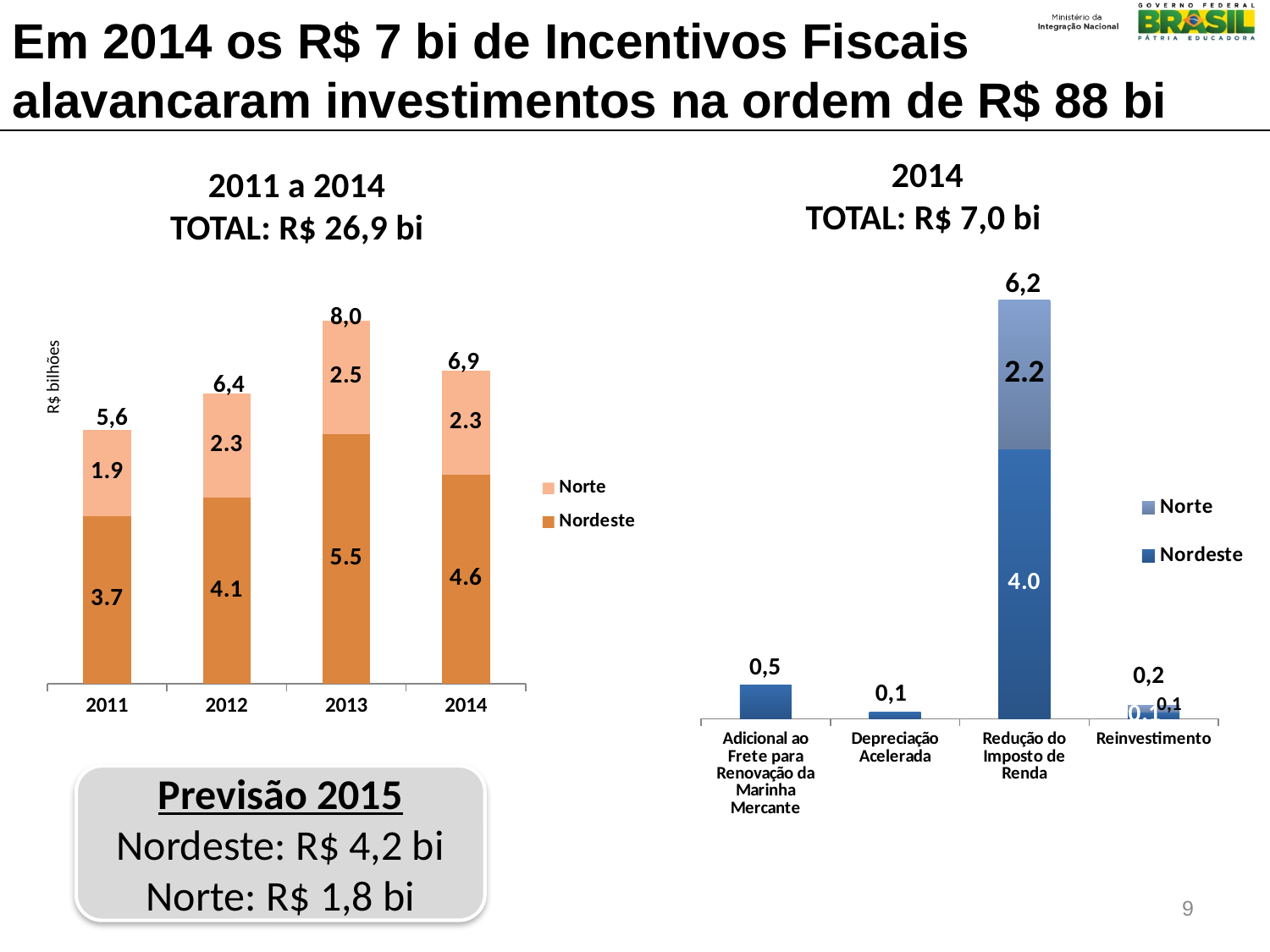
In the left chart (2011 a 2014), which year has the lowest total? 2011 In the left chart (2011 a 2014), what is the difference between the Nordeste values for 2013 and 2012? 1.4 In the right chart (2014 TOTAL: R$ 7,0 bi), what is the Nordeste value for Redução do Imposto de Renda? 4.0 In the left chart (2011 a 2014), what is the Norte value for 2011? 1.9 In the left chart (2011 a 2014), how many series does the legend list? 2 In the right chart (2014 TOTAL: R$ 7,0 bi), how many categories are shown on the x axis? 4 In the left chart (2011 a 2014), which year has the highest total? 2013 What kind of chart is the left chart (2011 a 2014)? Stacked bar chart In the right chart (2014 TOTAL: R$ 7,0 bi), which category has the lowest total? Depreciação Acelerada In the right chart (2014 TOTAL: R$ 7,0 bi), what is the total of the bar for Redução do Imposto de Renda? 6,2 In the left chart (2011 a 2014), what is the Nordeste value for 2013? 5.5 In the left chart (2011 a 2014), what is the total of the stacked bar for 2014? 6,9